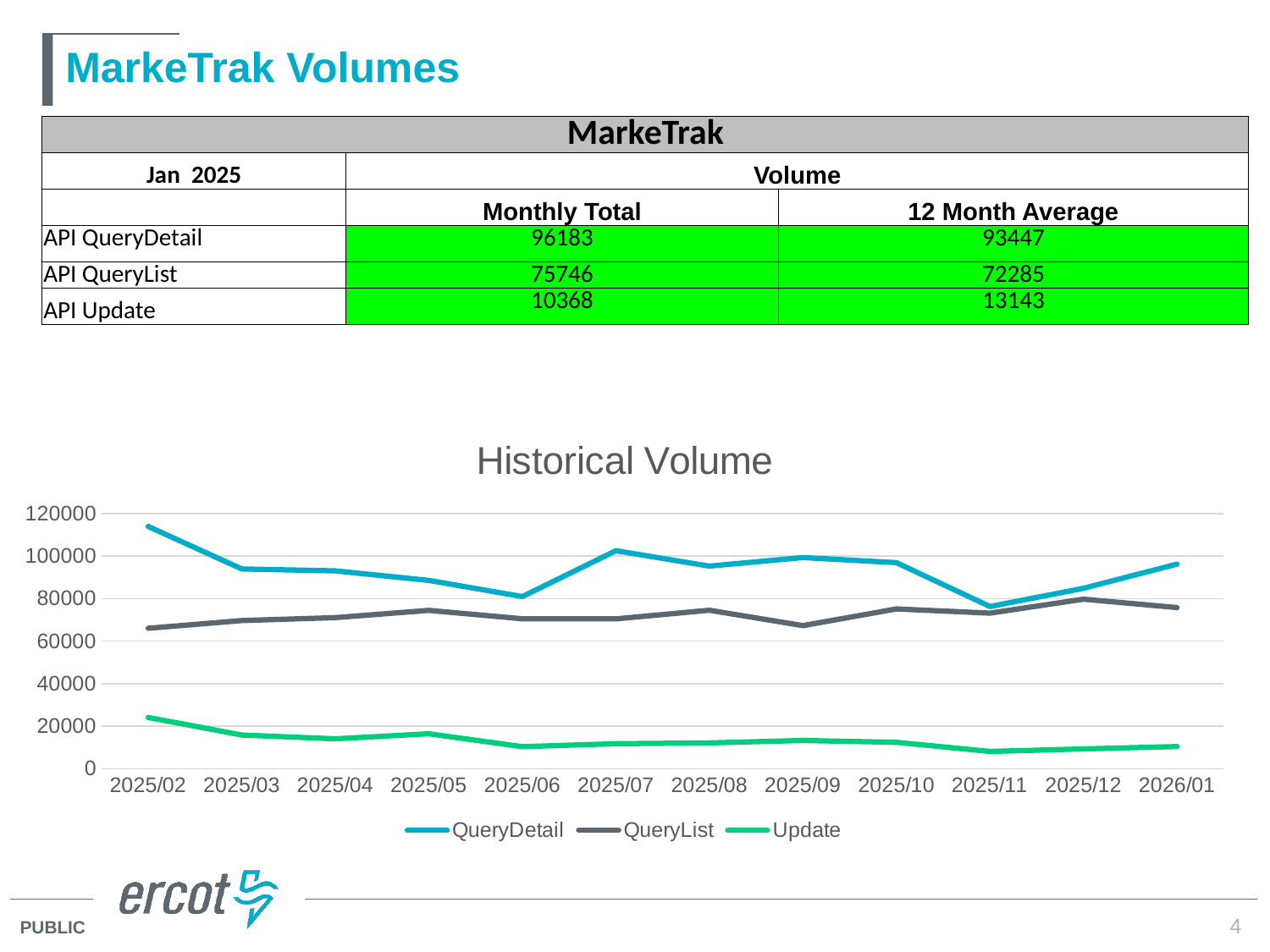
What kind of chart is the Historical Volume chart? line chart In the Historical Volume chart, is the QueryList value for 2025/09 greater or less than 80000? less In the Historical Volume chart, is the QueryDetail value for 2025/02 greater or less than 100000? greater In the Historical Volume chart, does the Update series rise or fall from 2025/02 to 2025/06? fall In the Historical Volume chart, which series has the lowest values across all months? Update In the Historical Volume chart, which series has the larger value at 2025/07, QueryDetail or QueryList? QueryDetail How many months are shown on the x axis of the Historical Volume chart? 12 In the Historical Volume chart, is the Update value for 2025/02 greater or less than 20000? greater How many series does the legend of the Historical Volume chart list? 3 In the Historical Volume chart, in which month does the Update series reach its highest value? 2025/02